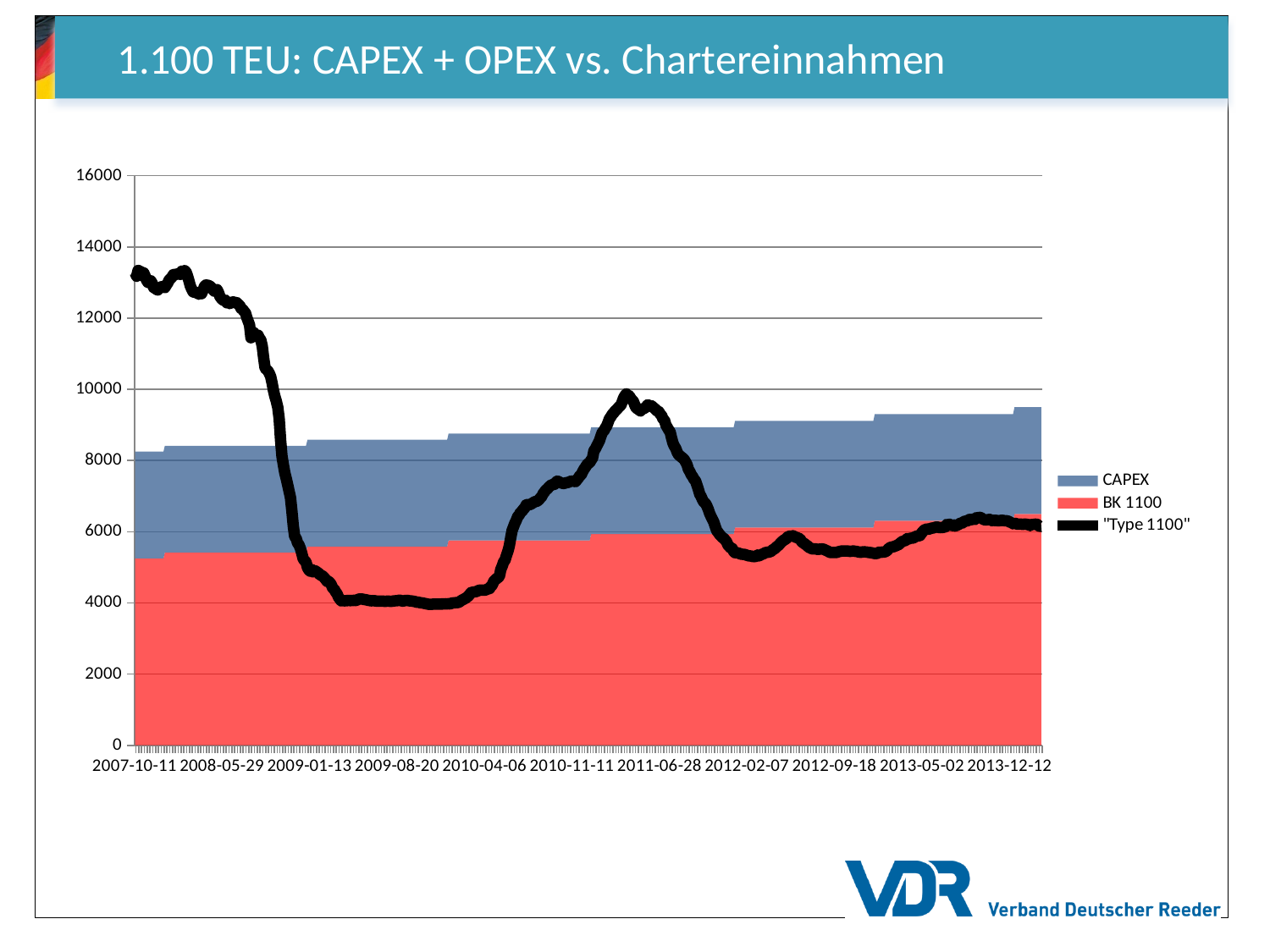
Is the BK 1100 value at 2007-10-11 greater or less than 6000? less Does the "Type 1100" line rise or fall between 2009-08-20 and 2011-06-28? rise What is the title of the chart on the slide? 1.100 TEU: CAPEX + OPEX vs. Chartereinnahmen What is the highest value shown on the vertical axis? 16000 Is the "Type 1100" value at 2009-08-20 greater or less than 6000? less What are the three series named in the legend? CAPEX, BK 1100, "Type 1100" Is the "Type 1100" value at 2007-10-11 greater or less than 12000? greater Does the "Type 1100" line rise or fall between 2007-10-11 and 2009-08-20? fall How many series does the legend list? 3 Is the "Type 1100" value higher at 2007-10-11 or at 2013-12-12? 2007-10-11